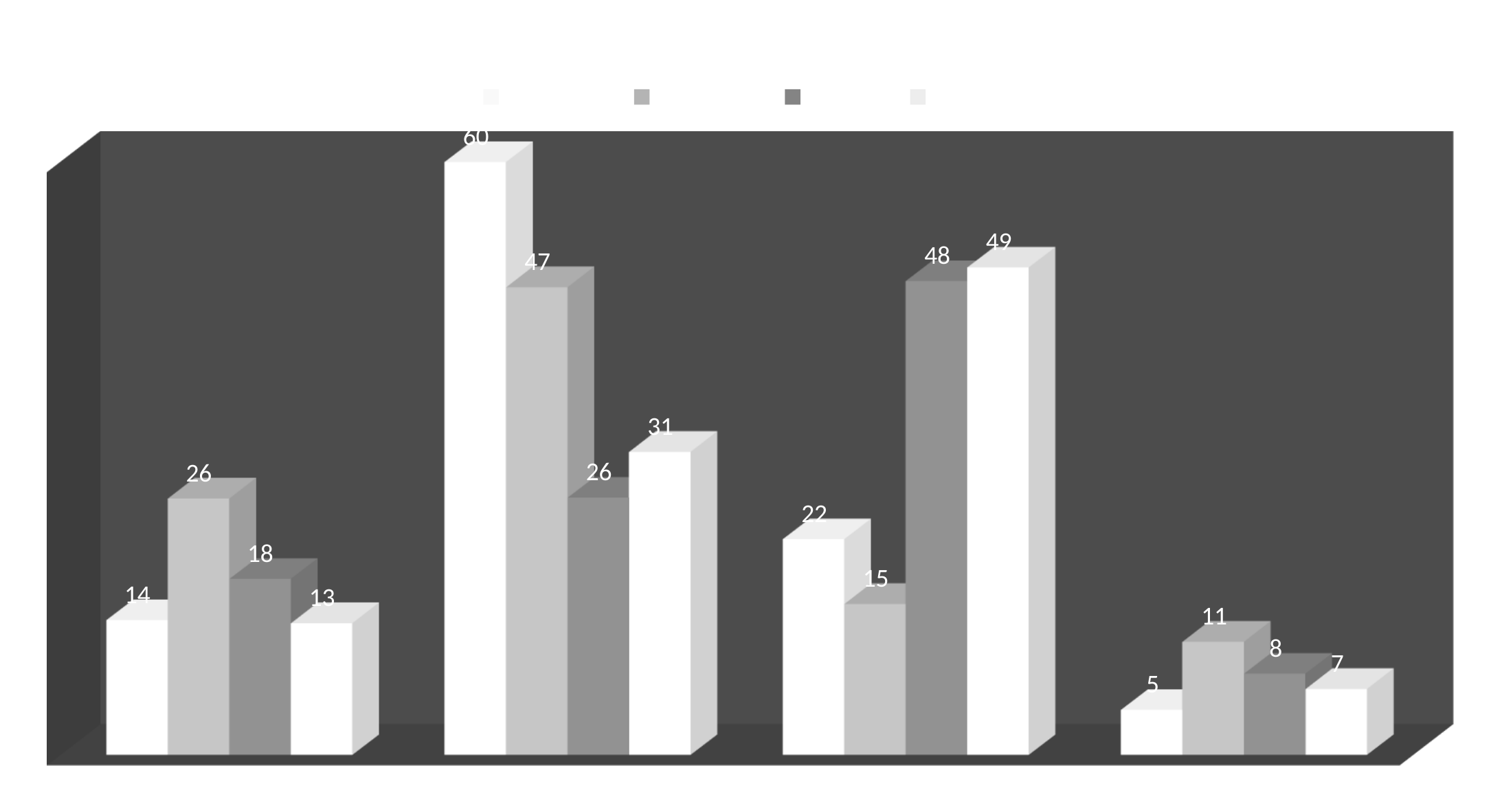
What is the difference between the first and second bars in the second group (60 and 47)? 13 What is the value of the tallest bar in the second group from the left? 60 Which is larger: the second bar in the first group (26) or the third bar in the first group (18)? the second bar (26) What is the value of the first (leftmost) bar in the first group? 14 How many series does the legend list? 4 What is the highest value shown on the chart? 60 What is the lowest value shown on the chart? 5 What kind of chart is shown on the slide? bar chart What is the value of the second bar in the fourth group from the left? 11 What is the difference between the third bar in the third group (48) and the second bar in the third group (15)? 33 How many groups of bars are plotted along the x axis? 4 What is the value of the last (rightmost) bar in the third group? 49